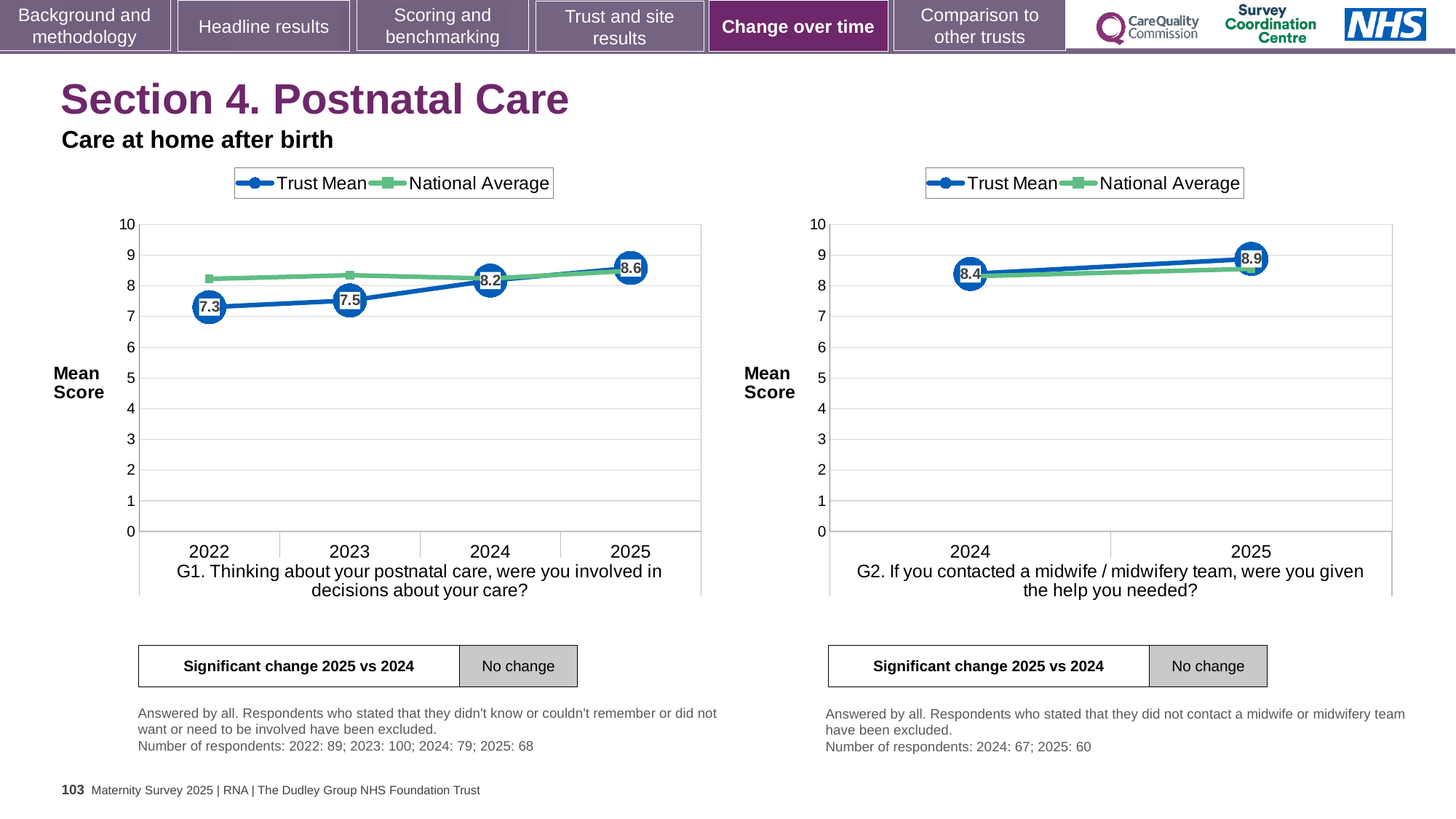
In the G2 chart on the right, what is the Trust Mean score for 2024? 8.4 In the G2 chart on the right, what is the difference between the Trust Mean scores for 2025 and 2024? 0.5 In the G1 chart on the left, which year has the lowest Trust Mean score? 2022 In the G1 chart on the left, is the National Average for 2022 greater or less than 7? greater How many years are plotted on the x axis of the G1 chart on the left? 4 In the G1 chart on the left, which year has the highest Trust Mean score? 2025 In the G1 chart on the left, what is the difference between the Trust Mean scores for 2025 and 2022? 1.3 In the G1 chart on the left, is the Trust Mean score for 2023 higher or lower than the Trust Mean score for 2024? lower In the G1 chart on the left, what is the Trust Mean score for 2022? 7.3 In the G2 chart on the right, what is the Trust Mean score for 2025? 8.9 In the G1 chart on the left, what is the Trust Mean score for 2025? 8.6 How many series does the legend of the G2 chart on the right list? 2